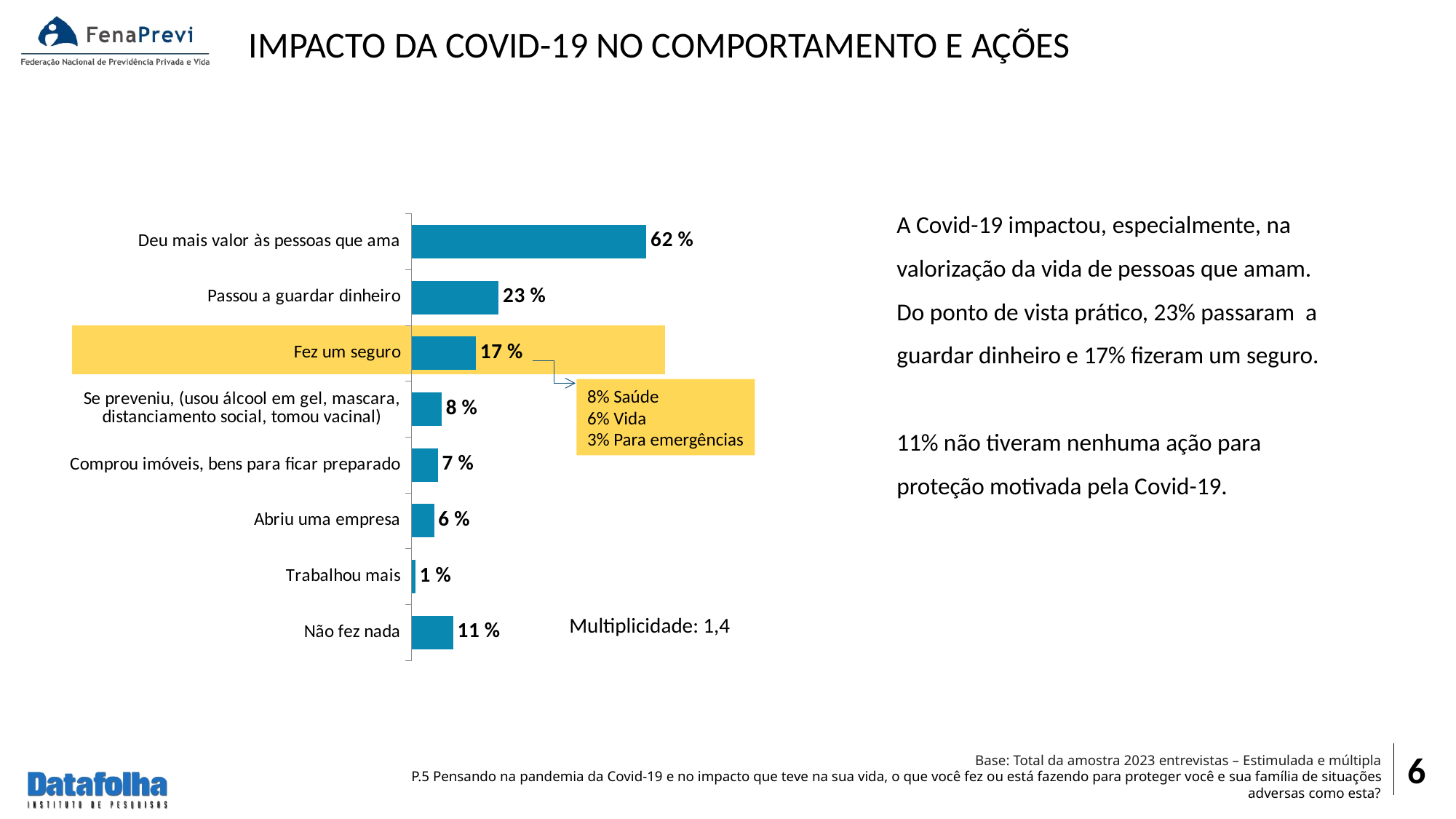
What is the value for "Deu mais valor às pessoas que ama"? 62 % What is the value for "Passou a guardar dinheiro"? 23 % What is the difference between "Deu mais valor às pessoas que ama" and "Passou a guardar dinheiro"? 39 % What is the value for "Não fez nada"? 11 % Which category has the highest value? Deu mais valor às pessoas que ama Which category has the lowest value? Trabalhou mais What is the value for "Fez um seguro"? 17 % How many categories are shown in the bar chart? 8 In the callout box for "Fez um seguro", what percentage is for "Vida"? 6% Which is larger, "Comprou imóveis, bens para ficar preparado" or "Abriu uma empresa"? Comprou imóveis, bens para ficar preparado What kind of chart is shown on the slide? Bar chart What is the "Multiplicidade" value shown next to the chart? 1,4